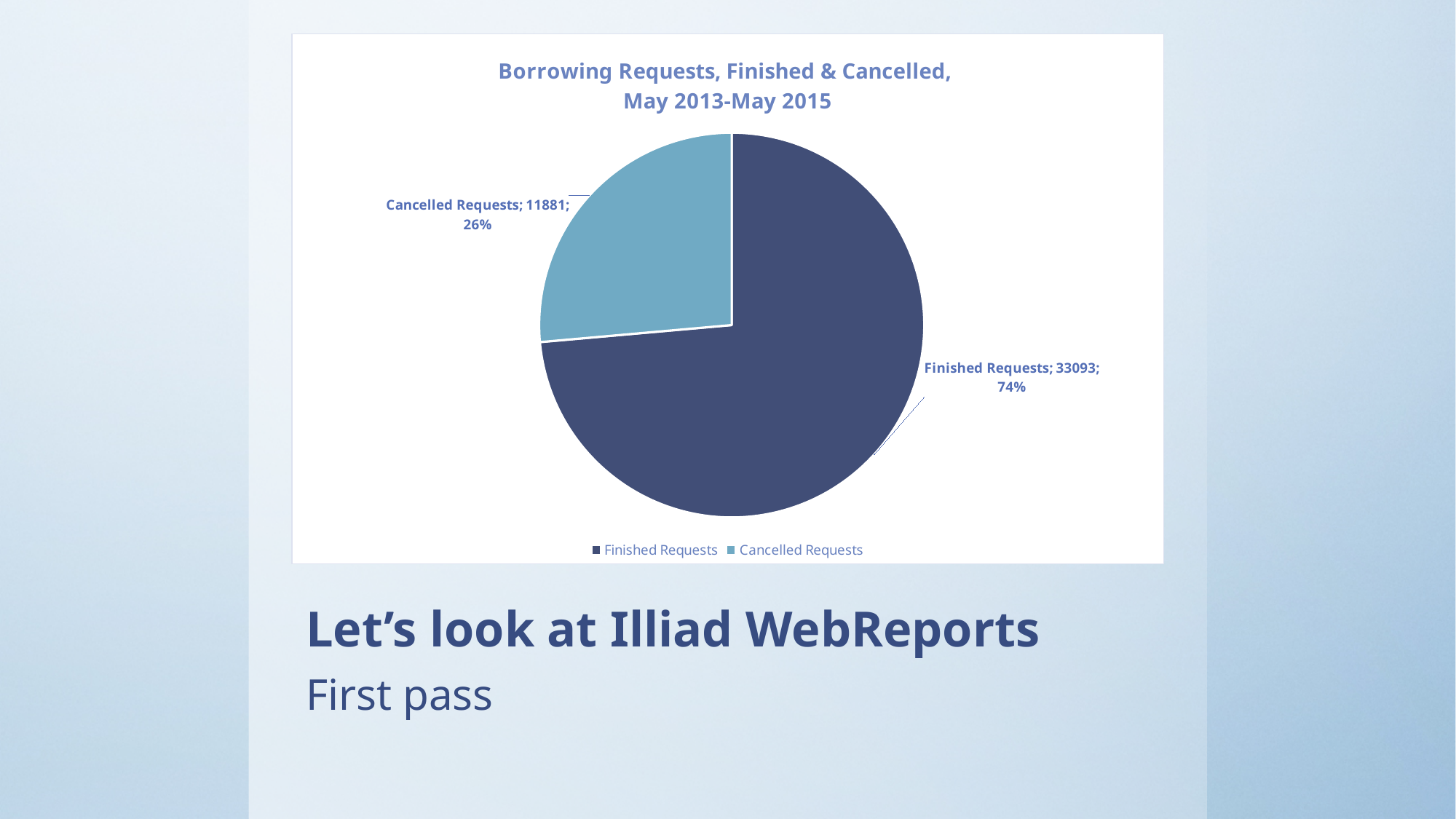
What is the value for Cancelled Requests? 11881 Which category has the largest slice? Finished Requests What share of the pie is Cancelled Requests? 26% What share of the pie is Finished Requests? 74% Which category has the smallest slice? Cancelled Requests How many entries does the legend list? 2 What is the value for Finished Requests? 33093 What kind of chart is shown on the slide? pie chart What is the difference between Finished Requests and Cancelled Requests? 21212 How many slices does the pie chart have? 2 What is the total of Finished Requests and Cancelled Requests? 44974 What is the title of the chart? Borrowing Requests, Finished & Cancelled, May 2013-May 2015